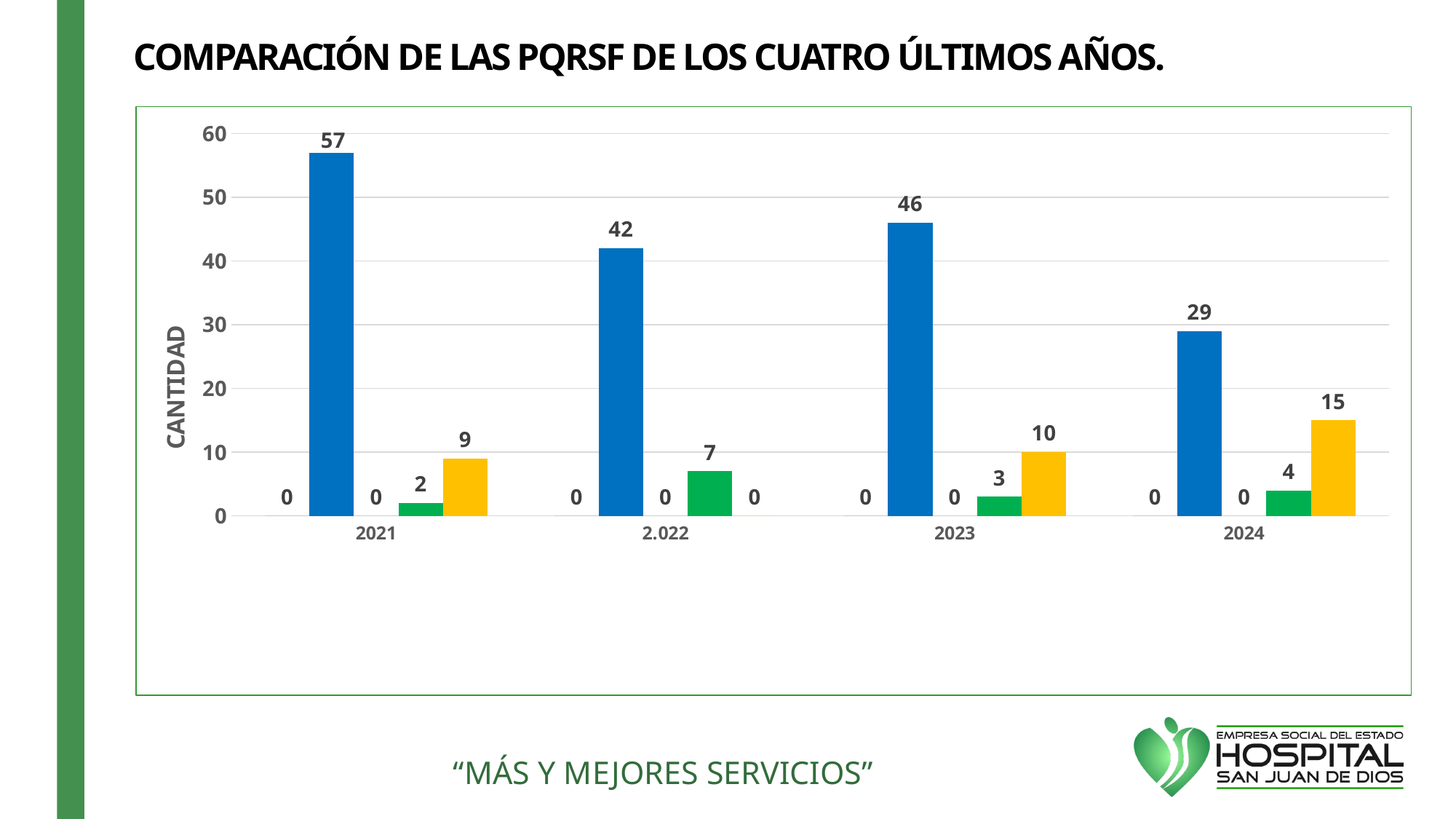
What kind of chart is shown on the slide? bar chart In which year is the blue bar highest? 2021 What is the value of the yellow bar for 2024? 15 What is the difference between the blue bar values for 2021 and 2024? 28 How many years are shown on the x axis? 4 What is the label of the vertical axis? CANTIDAD In which year is the blue bar lowest? 2024 What is the value of the green bar for 2.022? 7 Which is larger, the yellow bar for 2023 or the yellow bar for 2021? 2023 What is the value of the blue bar for 2021? 57 What is the value of the yellow bar for 2.022? 0 Is the blue bar for 2023 greater or less than 40? greater